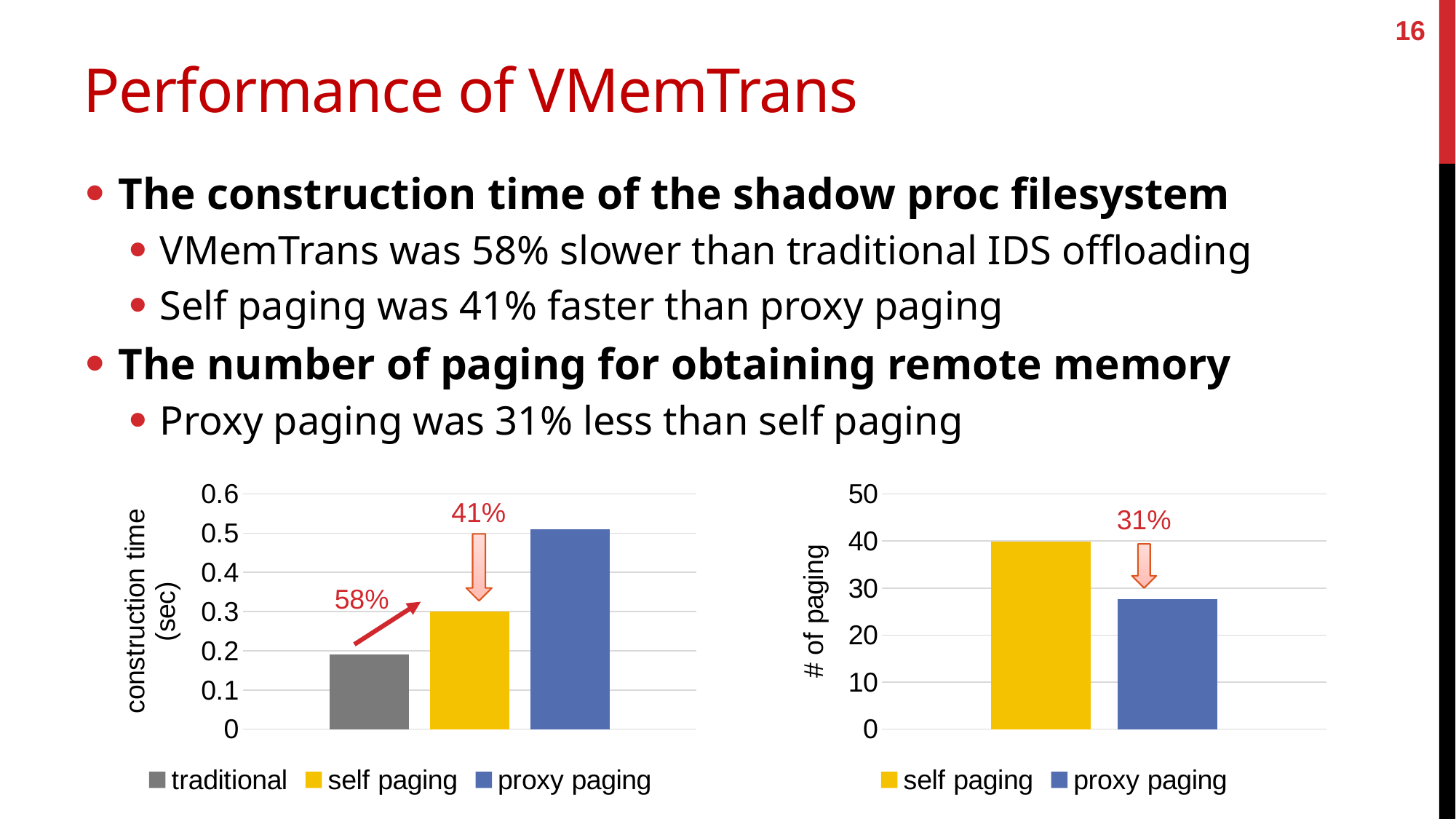
In the right chart (# of paging), is the value for proxy paging greater or less than 30? less In the left chart (construction time), what is the label on the vertical axis? construction time (sec) In the left chart (construction time), which series has the lowest construction time? traditional In the left chart (construction time), how many series does the legend list? 3 In the right chart (# of paging), which series has the lower number of paging? proxy paging In the left chart (construction time), what is the construction time for self paging? 0.3 In the left chart (construction time), which series has the highest construction time? proxy paging In the right chart (# of paging), how many series does the legend list? 2 What type of chart is the left chart (construction time)? bar chart